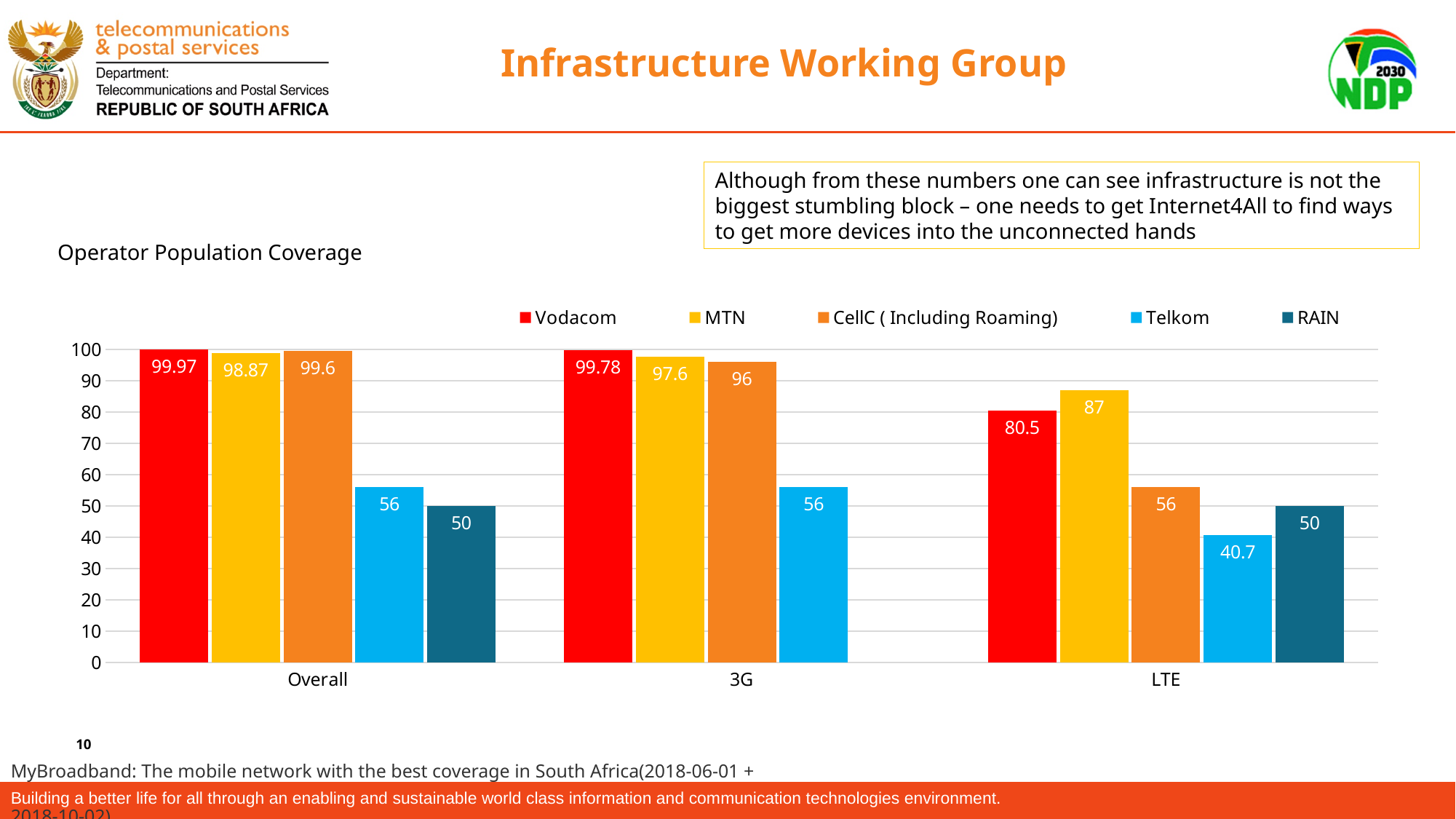
How many series does the legend list? 5 What is the Telkom value for LTE? 40.7 Which operator has the highest value for LTE? MTN How many categories are shown on the x axis? 3 What is the title of the chart? Operator Population Coverage Which operator has the lowest value for LTE? Telkom What kind of chart is shown on the slide? Bar chart Which category has no RAIN bar? 3G What is the Vodacom value for the Overall category? 99.97 What is the MTN value for 3G? 97.6 What is the difference between the MTN and Vodacom values for LTE? 6.5 Which is larger for 3G: the CellC (Including Roaming) value or the Telkom value? CellC ( Including Roaming)